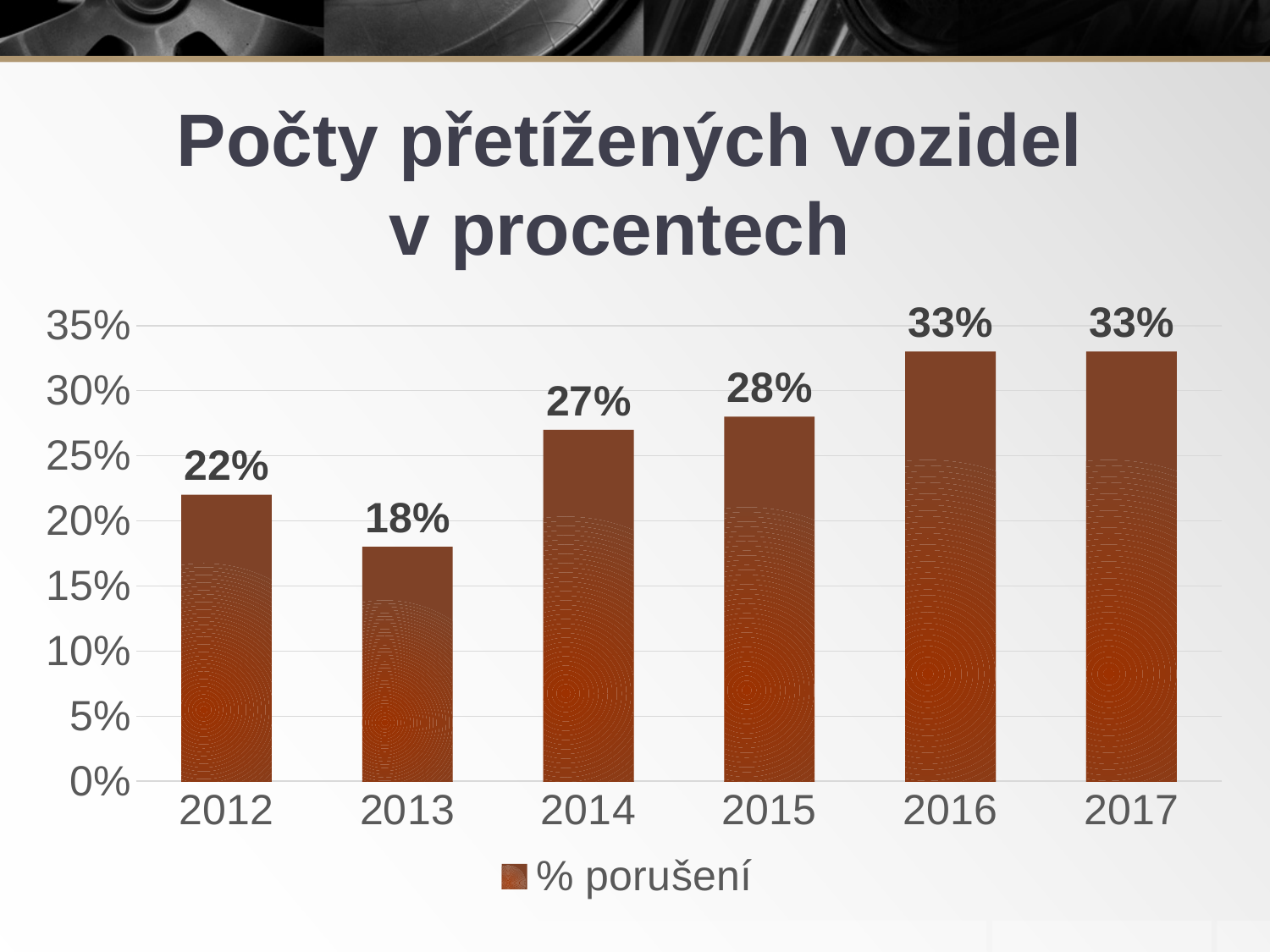
How many series does the legend list? 1 What is the value for 2012? 22% What kind of chart is shown on the slide? bar chart What is the value for 2015? 28% What is the difference between the values for 2014 and 2013? 9% Is the value for 2013 greater or less than 20%? less Which year has the lowest value? 2013 How many years are shown on the x axis? 6 Which is larger, the value for 2014 or the value for 2012? 2014 What is the legend entry for the series? % porušení What is the difference between the values for 2016 and 2012? 11% What is the highest value shown in the chart? 33%